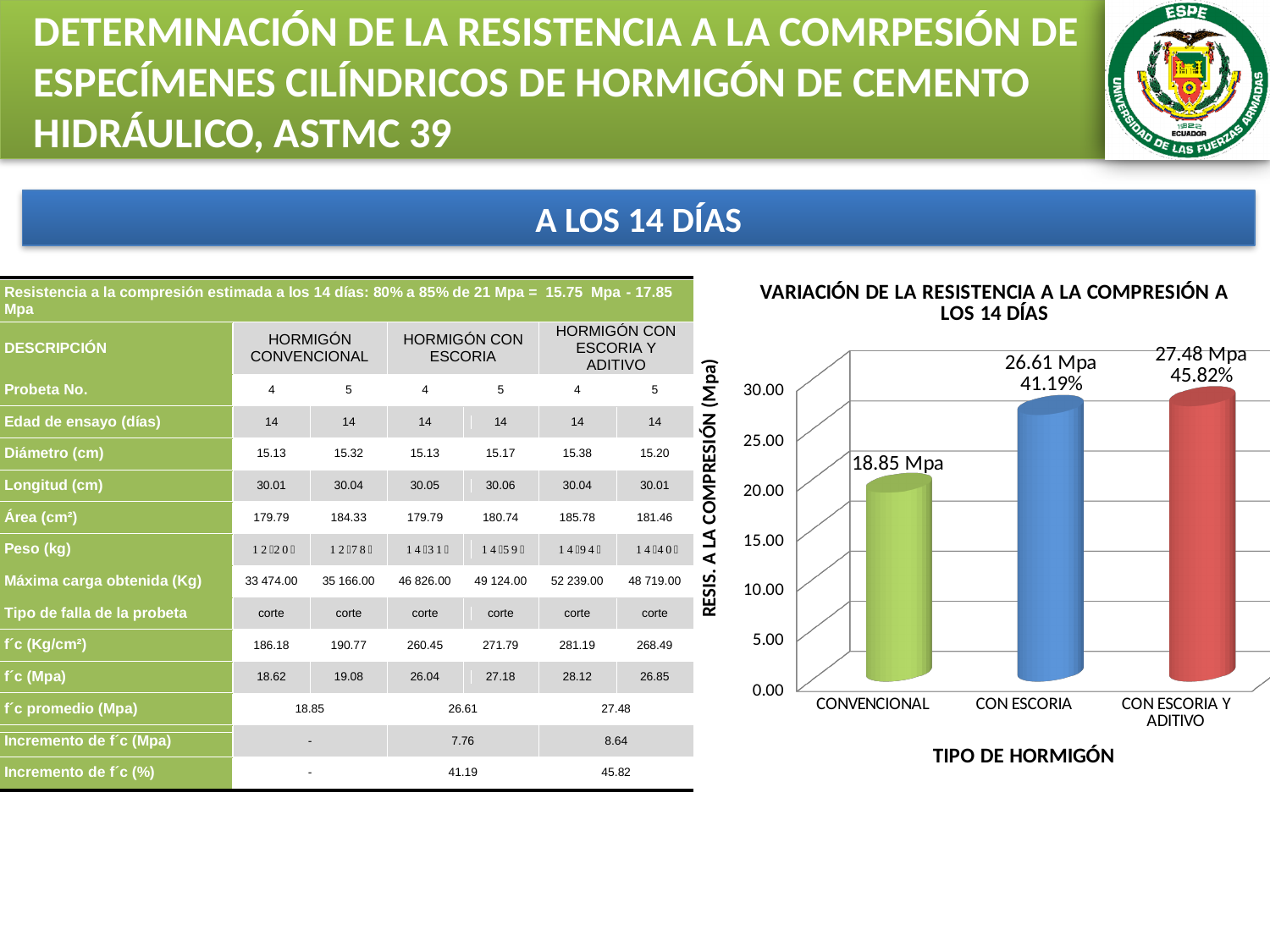
Do the values rise or fall from left to right along the x axis? rise What percentage increase is labelled above the CON ESCORIA bar? 41.19% Which is larger, the value for CON ESCORIA or for CON ESCORIA Y ADITIVO? CON ESCORIA Y ADITIVO What is the value for CON ESCORIA Y ADITIVO in the chart? 27.48 Mpa How many types of hormigón are plotted in the chart? 3 Which type of hormigón has the lowest compressive strength in the chart? CONVENCIONAL What type of chart is shown on the slide? bar chart Is the value for CONVENCIONAL greater or less than 20.00? less Which type of hormigón has the highest compressive strength in the chart? CON ESCORIA Y ADITIVO What is the value for CONVENCIONAL in the chart? 18.85 Mpa What is the difference in Mpa between CON ESCORIA and CONVENCIONAL? 7.76 Mpa What is the value for CON ESCORIA in the chart? 26.61 Mpa